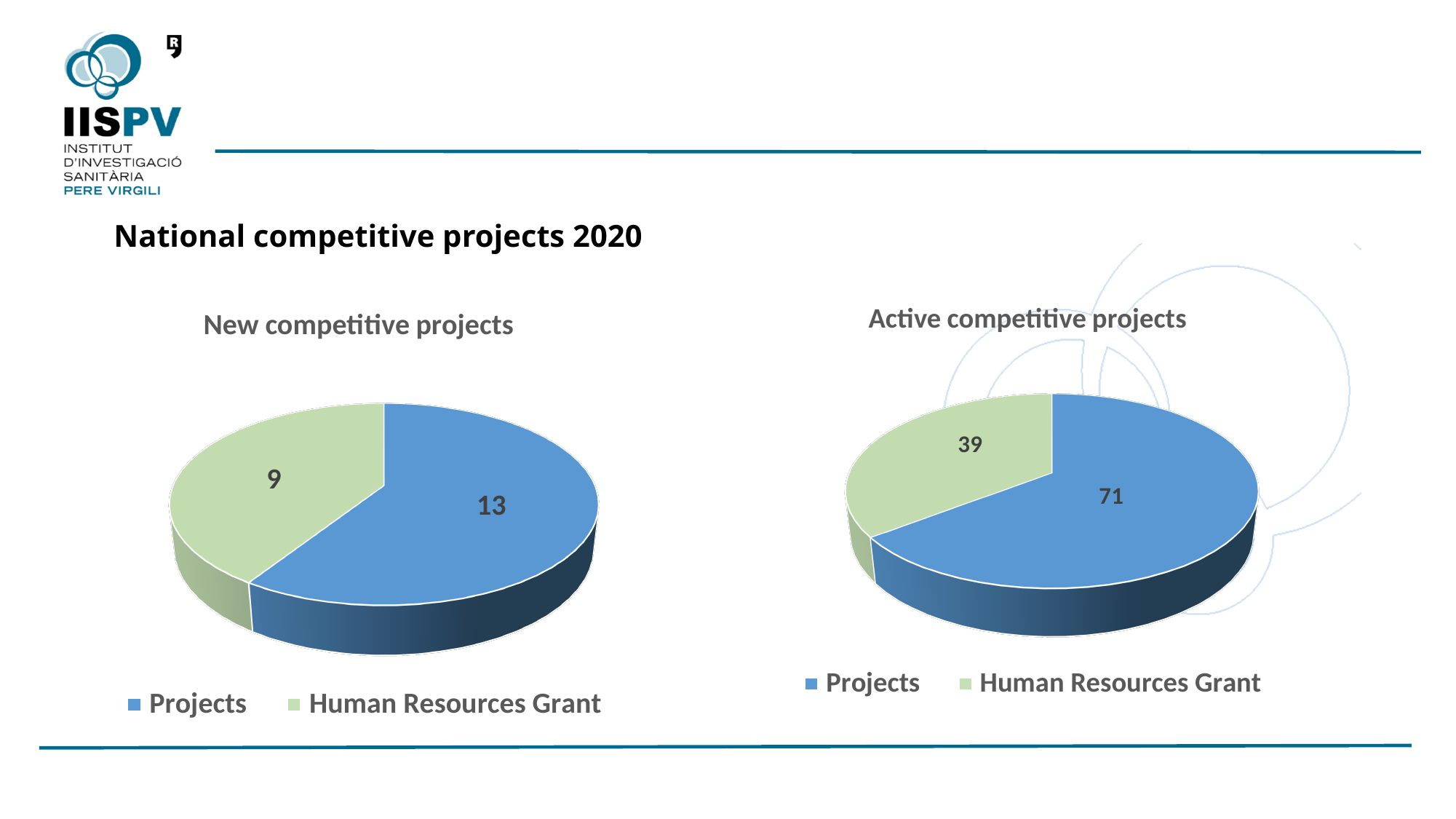
In the 'Active competitive projects' chart, what is the difference between Projects and Human Resources Grant? 32 In the 'New competitive projects' chart, which category has the smallest slice? Human Resources Grant In the 'New competitive projects' chart, what is the value for Human Resources Grant? 9 In the 'New competitive projects' chart, what is the difference between Projects and Human Resources Grant? 4 In the 'Active competitive projects' chart, which category has the largest slice? Projects What type of chart is the 'New competitive projects' chart? Pie chart In the 'Active competitive projects' chart, what is the value for Projects? 71 In the 'New competitive projects' chart, what is the value for Projects? 13 In the 'Active competitive projects' chart, which is larger: Projects or Human Resources Grant? Projects How many categories does the 'Active competitive projects' chart show? 2 In the 'Active competitive projects' chart, what is the value for Human Resources Grant? 39 What is the title of the slide above the two charts? National competitive projects 2020